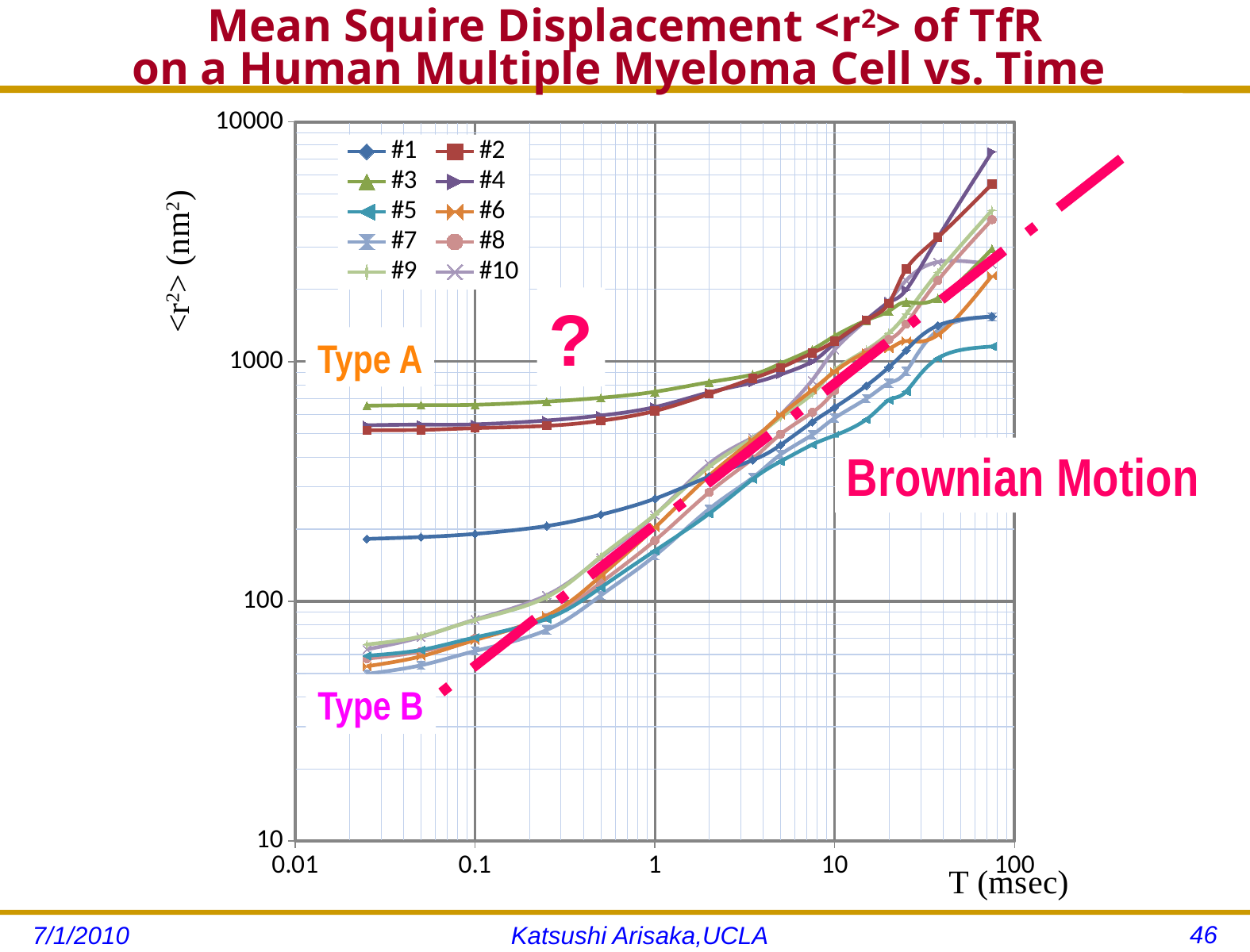
Is the value of series #5 at T = 0.1 msec greater or less than 100? less What kind of chart is shown on the slide? line chart Is the value of series #1 at T = 1 msec greater or less than 1000? less Is the value of series #3 at T = 0.1 msec greater or less than 100? greater What is the label of the x axis? T (msec) How many series does the legend list? 10 At T = 0.1 msec, which series has the larger value, #2 or #1? #2 Which series reaches the highest value at the rightmost end of the chart? #4 Do the <r²> values rise or fall as T increases along the x axis? rise